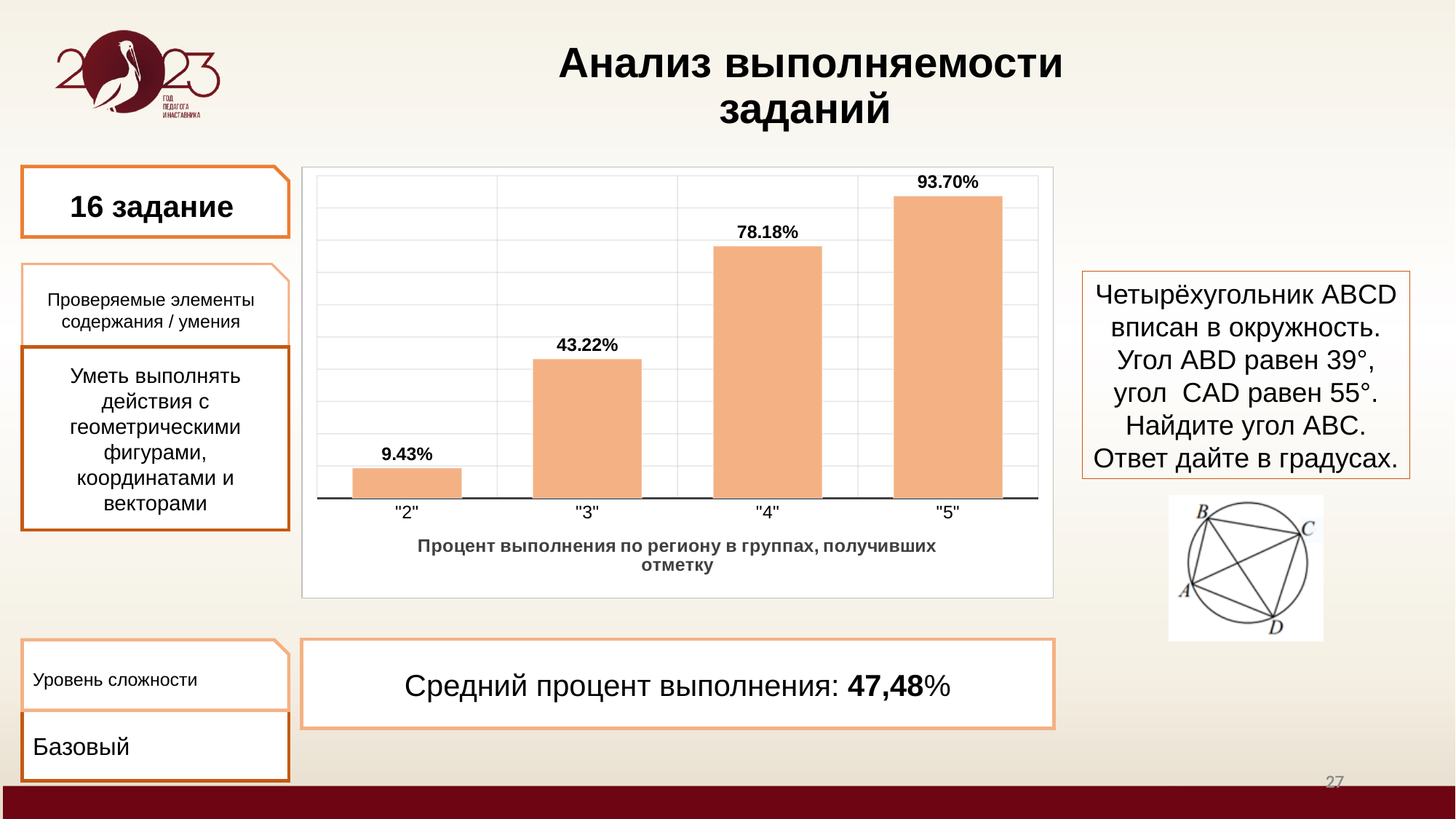
What type of chart is shown on the slide? Bar chart Do the completion percentages rise or fall from mark "2" to mark "5"? Rise What is the completion percentage for the group that received mark "2"? 9.43% What is the completion percentage for the group that received mark "4"? 78.18% Which mark group has the highest completion percentage? "5" Which group has a higher completion percentage, "3" or "4"? "4" What is the completion percentage for the group that received mark "3"? 43.22% What is the difference between the completion percentages of the "3" group and the "2" group? 33.79% What is the completion percentage for the group that received mark "5"? 93.70% Which mark group has the lowest completion percentage? "2" What is the difference between the completion percentages of the "5" group and the "4" group? 15.52% How many mark groups are shown on the chart? 4